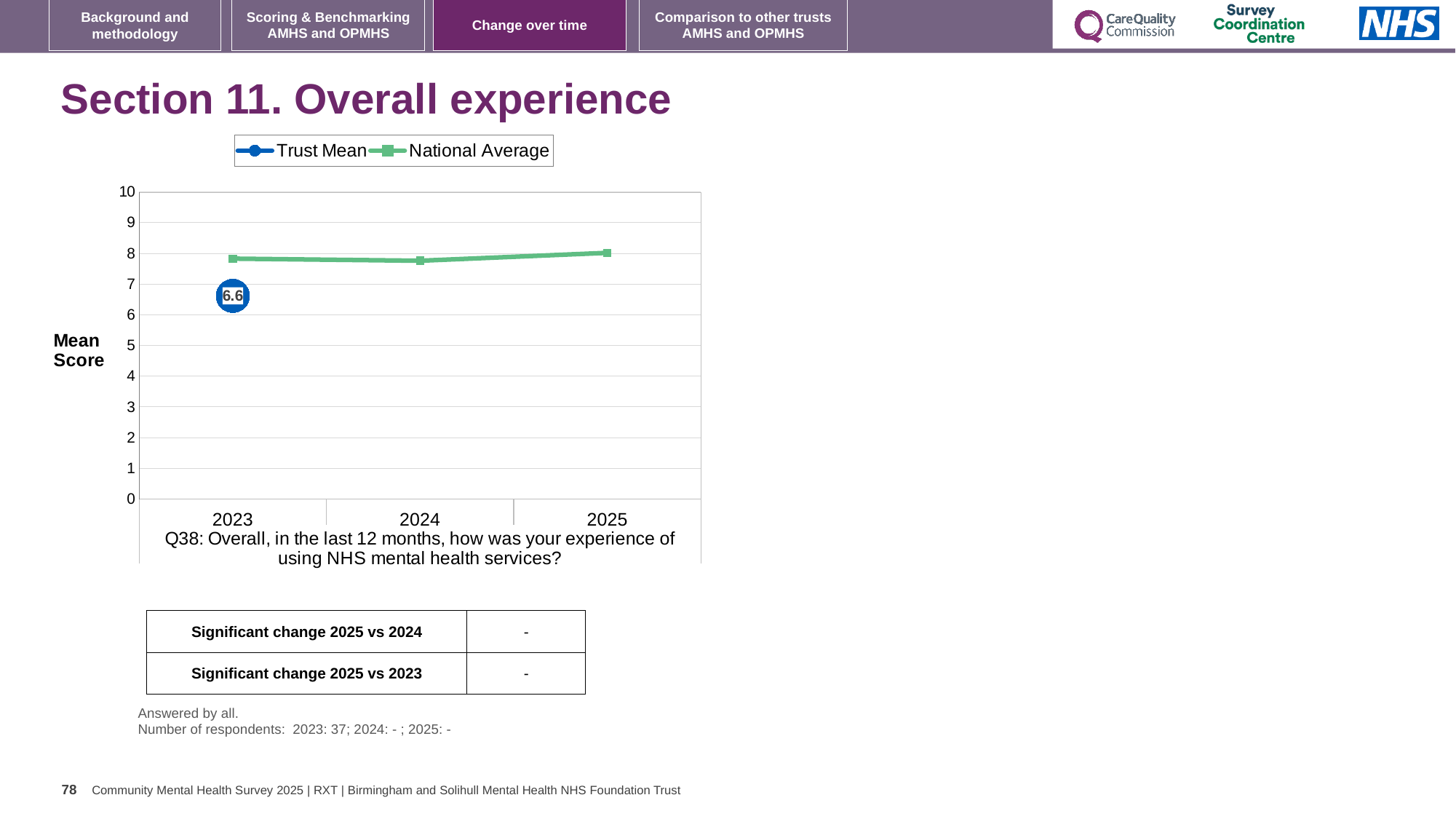
What kind of chart is shown on the slide? line chart Is the National Average value for 2025 greater or less than 9? less How many years are shown on the x axis? 3 Does the National Average rise or fall from 2024 to 2025? rise What is the Trust Mean score for 2023? 6.6 Is the Trust Mean value for 2023 greater or less than 7? less How many series does the legend list? 2 What are the two series named in the legend? Trust Mean and National Average In which year is the National Average highest? 2025 What is the label on the y axis? Mean Score In 2023, which is higher: the Trust Mean or the National Average? National Average Is the National Average value for 2023 greater or less than 7? greater